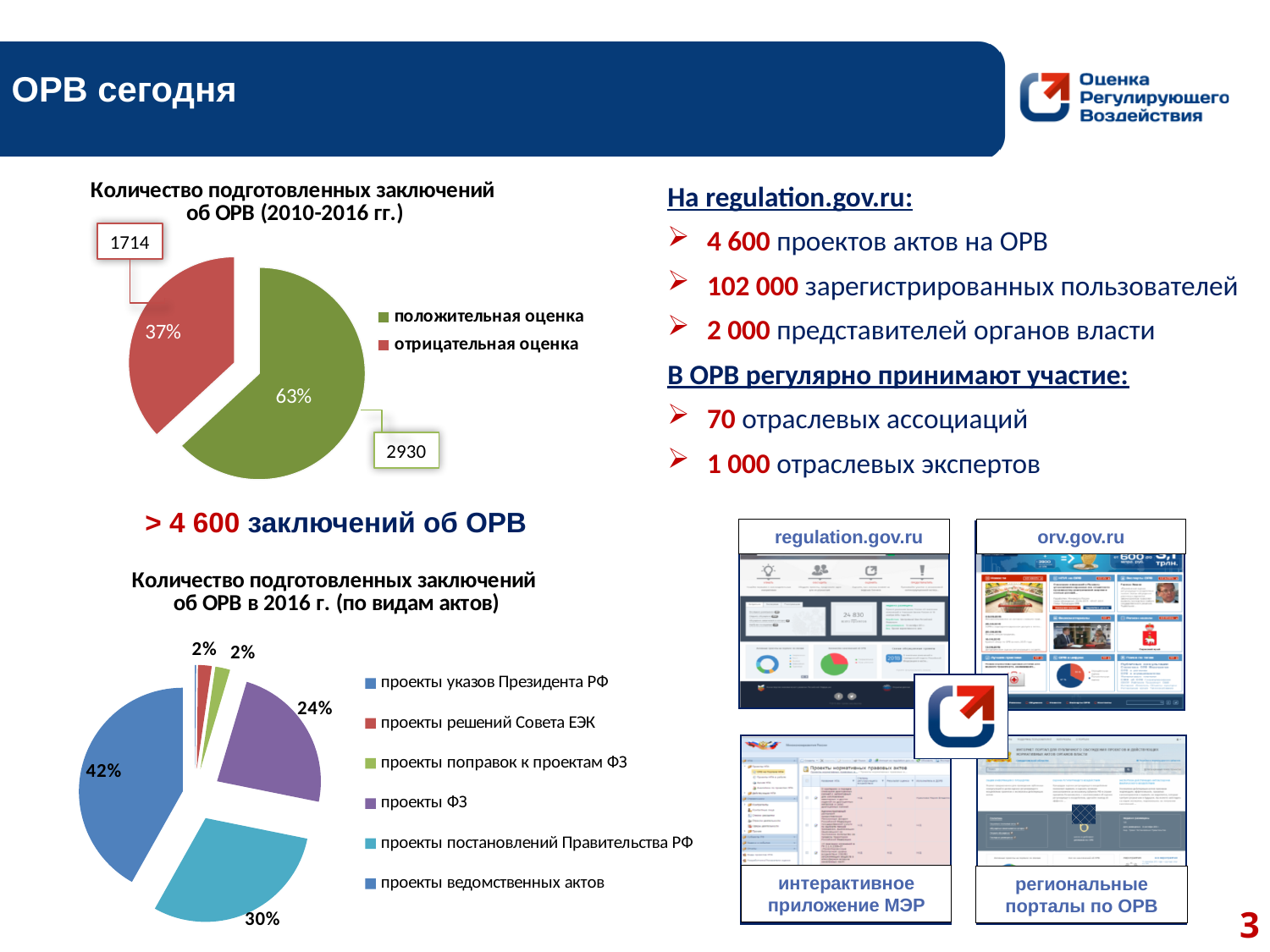
In the pie chart titled "Количество подготовленных заключений об ОРВ (2010-2016 гг.)", what number is shown in the callout for the "отрицательная оценка" slice? 1714 What kind of chart is the one titled "Количество подготовленных заключений об ОРВ (2010-2016 гг.)"? Pie chart In the pie chart titled "Количество подготовленных заключений об ОРВ в 2016 г. (по видам актов)", what percentage is shown for "проекты ведомственных актов"? 42% How many categories does the legend of the chart titled "Количество подготовленных заключений об ОРВ в 2016 г. (по видам актов)" list? 6 In the pie chart titled "Количество подготовленных заключений об ОРВ (2010-2016 гг.)", what is the difference between the number of positive and negative assessments (2930 and 1714)? 1216 In the pie chart titled "Количество подготовленных заключений об ОРВ в 2016 г. (по видам актов)", what percentage is shown for "проекты постановлений Правительства РФ"? 30% How many entries does the legend of the chart titled "Количество подготовленных заключений об ОРВ (2010-2016 гг.)" list? 2 In the pie chart titled "Количество подготовленных заключений об ОРВ в 2016 г. (по видам актов)", what percentage is shown for "проекты ФЗ"? 24% In the pie chart titled "Количество подготовленных заключений об ОРВ (2010-2016 гг.)", what number is shown in the callout for the "положительная оценка" slice? 2930 In the pie chart titled "Количество подготовленных заключений об ОРВ (2010-2016 гг.)", what percentage is shown for "отрицательная оценка"? 37% In the pie chart titled "Количество подготовленных заключений об ОРВ в 2016 г. (по видам актов)", which category has the largest share? проекты ведомственных актов In the pie chart titled "Количество подготовленных заключений об ОРВ (2010-2016 гг.)", what percentage is shown for "положительная оценка"? 63%